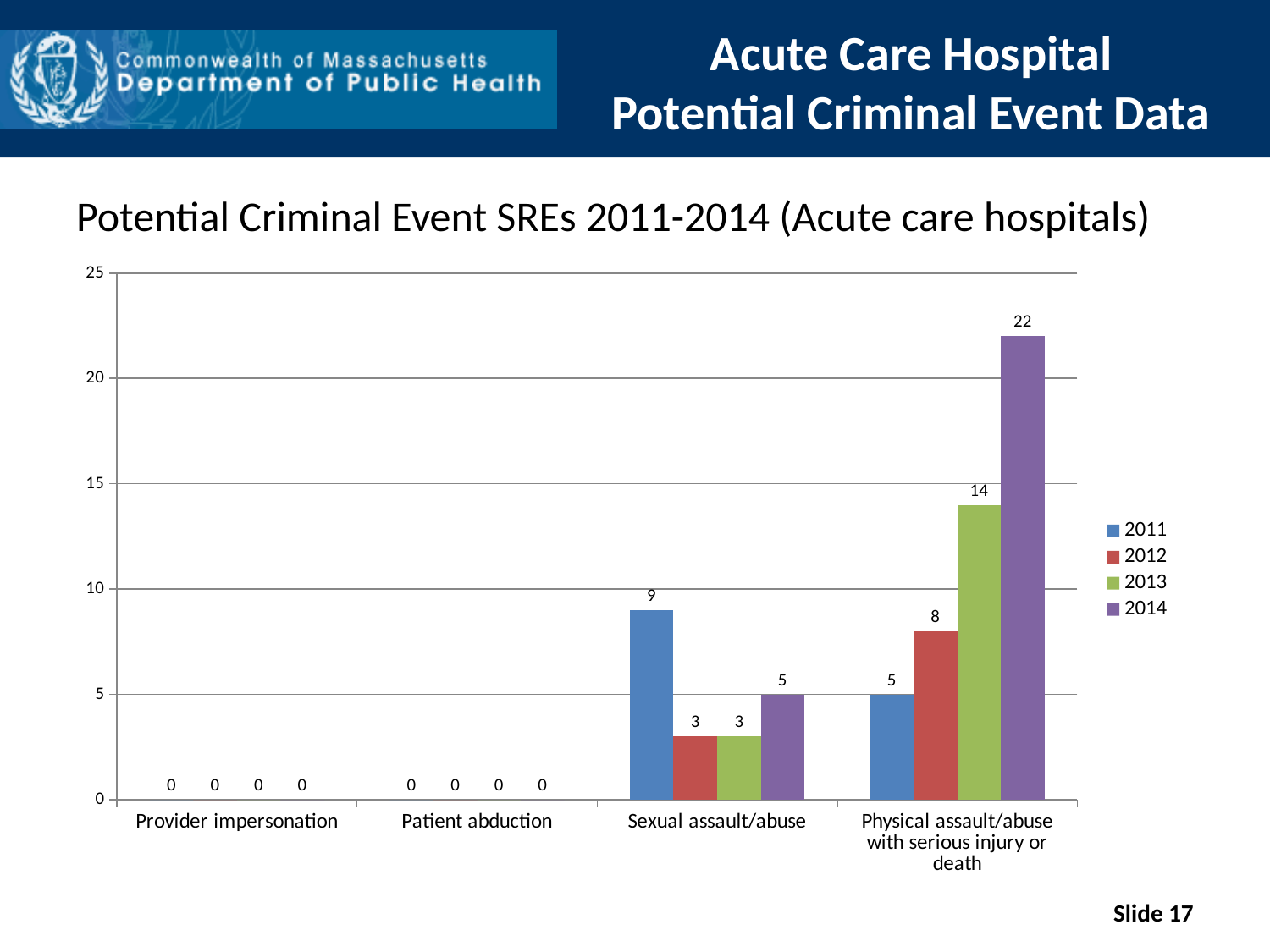
What is the value for Physical assault/abuse with serious injury or death in 2013? 14 Which category has the highest value in 2014? Physical assault/abuse with serious injury or death What kind of chart is shown on the slide? Bar chart What is the value for Sexual assault/abuse in 2012? 3 What is the value for Sexual assault/abuse in 2011? 9 How many series does the legend list? 4 What is the value for Physical assault/abuse with serious injury or death in 2014? 22 Which is larger: the 2011 value for Sexual assault/abuse or the 2011 value for Physical assault/abuse with serious injury or death? Sexual assault/abuse What is the difference between the 2014 and 2013 values for Physical assault/abuse with serious injury or death? 8 What is the difference between the 2011 and 2014 values for Sexual assault/abuse? 4 How many categories are shown on the x axis? 4 Do the values for Physical assault/abuse with serious injury or death rise or fall from 2011 to 2014? Rise